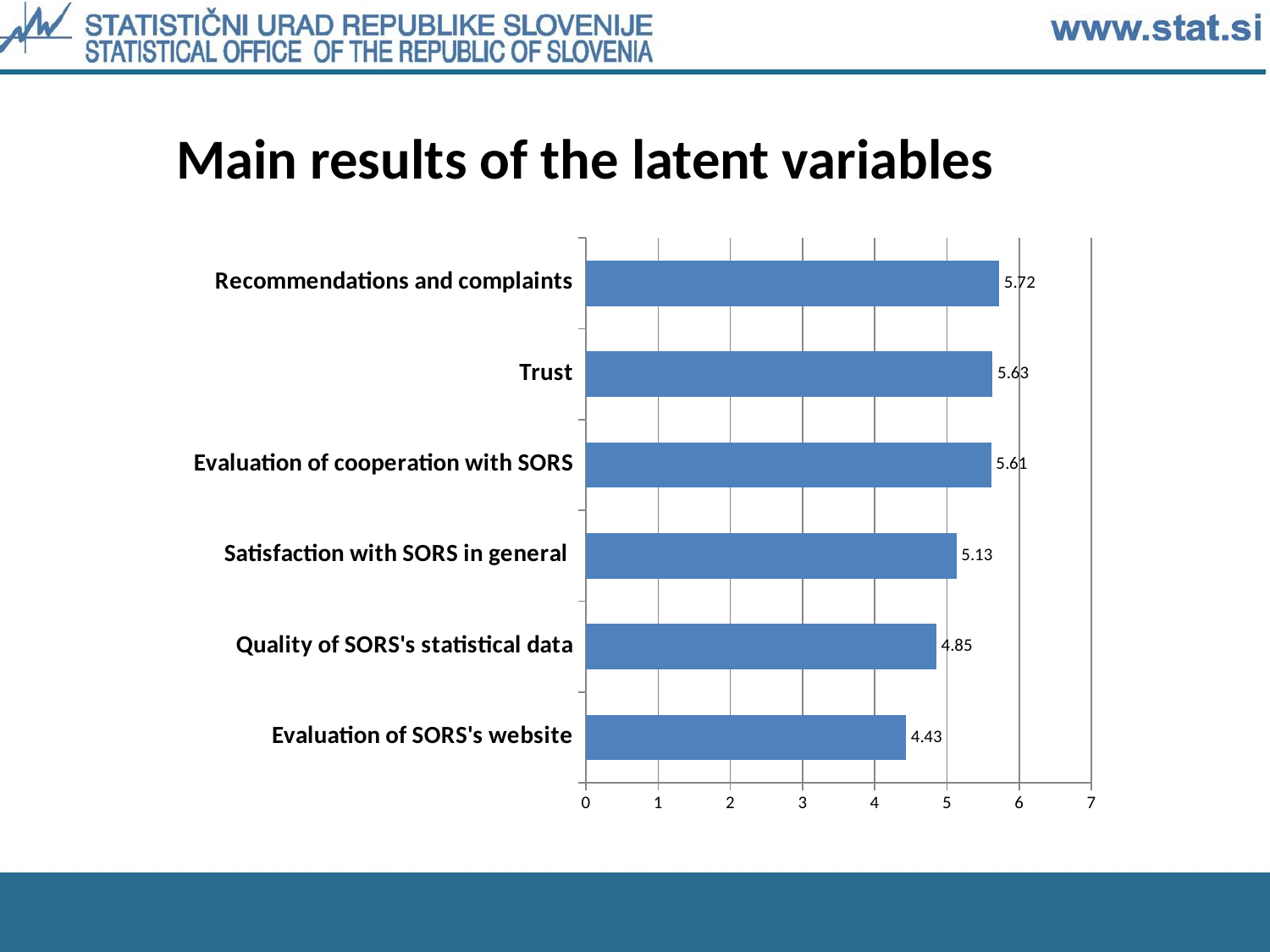
What is the difference between the values for Recommendations and complaints and Evaluation of SORS's website? 1.29 What is the value for Satisfaction with SORS in general? 5.13 What is the value for Trust? 5.63 Which is larger, the value for Quality of SORS's statistical data or the value for Satisfaction with SORS in general? Satisfaction with SORS in general How many categories are shown in the chart? 6 What kind of chart is shown on the slide? bar chart What is the value for Evaluation of SORS's website? 4.43 What is the title of the slide containing the chart? Main results of the latent variables Which category has the lowest value? Evaluation of SORS's website Which category has the highest value? Recommendations and complaints Is the value for Quality of SORS's statistical data greater or less than 5? less What is the difference between the values for Satisfaction with SORS in general and Quality of SORS's statistical data? 0.28